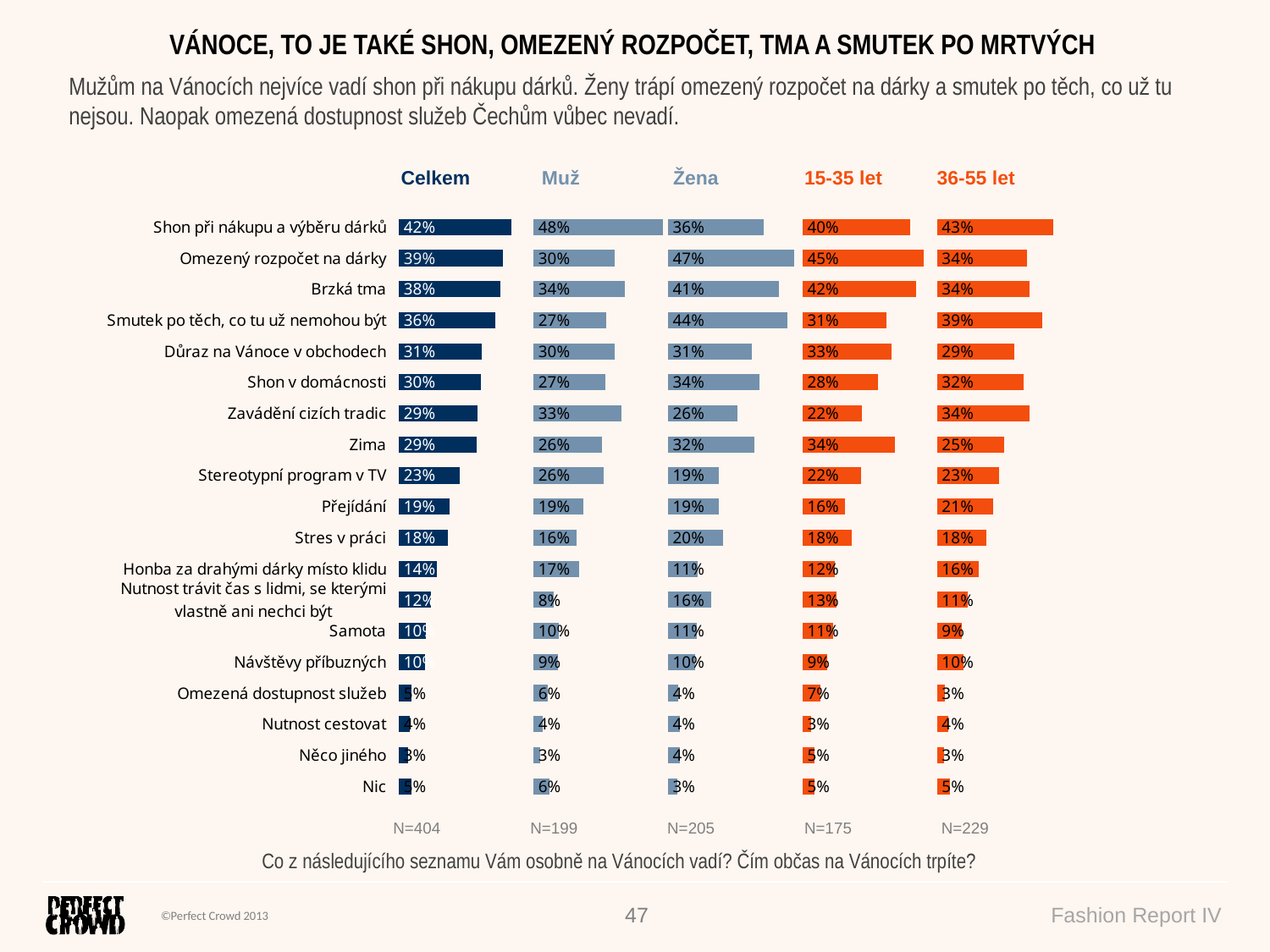
In the Žena chart, which category has the lowest value? Nic How many categories are listed in the Celkem chart? 19 In the 15-35 let chart, what is the value for Zavádění cizích tradic? 22% In the Muž chart, which category has the highest value? Shon při nákupu a výběru dárků In the Muž chart, what is the value for Smutek po těch, co tu už nemohou být? 27% What kind of chart is used on this slide? Bar chart For Smutek po těch, co tu už nemohou být, which is larger: the 15-35 let value or the 36-55 let value? 36-55 let What is the difference between the Žena and Muž values for Omezený rozpočet na dárky? 17 percentage points In the Žena chart, which category has the highest value? Omezený rozpočet na dárky In the 36-55 let chart, what is the value for Přejídání? 21% In the Žena chart, what is the value for Zima? 32% In the Celkem chart, what is the value for Brzká tma? 38%